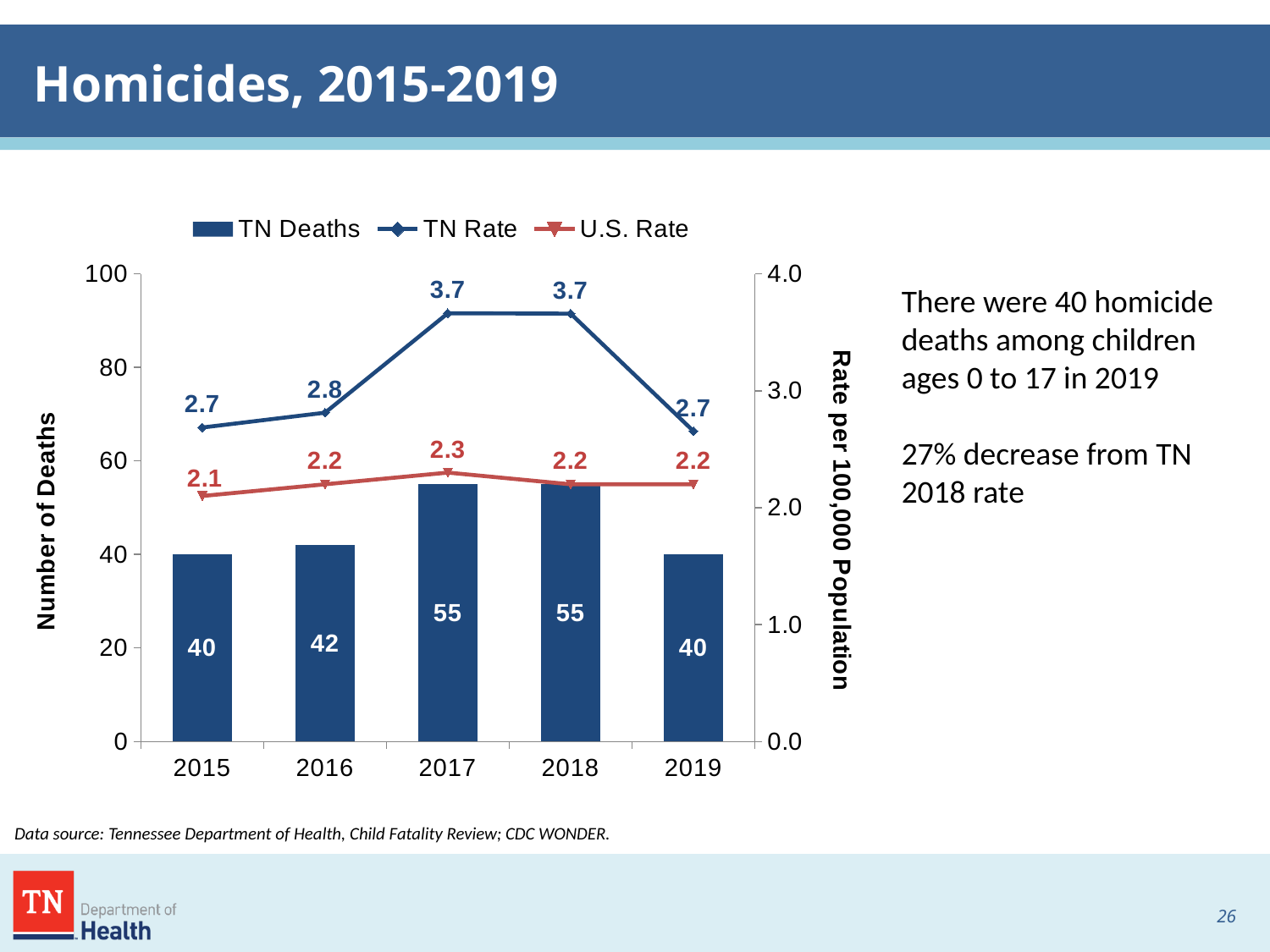
Which is larger, the TN Rate in 2018 or the TN Rate in 2019? TN Rate in 2018 What is the title of the slide? Homicides, 2015-2019 How many series does the legend list? 3 How many TN deaths were there in 2017? 55 Which year had the highest U.S. Rate? 2017 What is the difference between TN Deaths in 2018 and 2019? 15 How many years are shown on the x axis? 5 What was the U.S. Rate in 2015? 2.1 Did the TN Rate rise or fall from 2018 to 2019? fall What is the difference between the TN Rate and the U.S. Rate in 2017? 1.4 What was the TN Rate in 2016? 2.8 Which year had the lowest TN Rate? 2015 and 2019